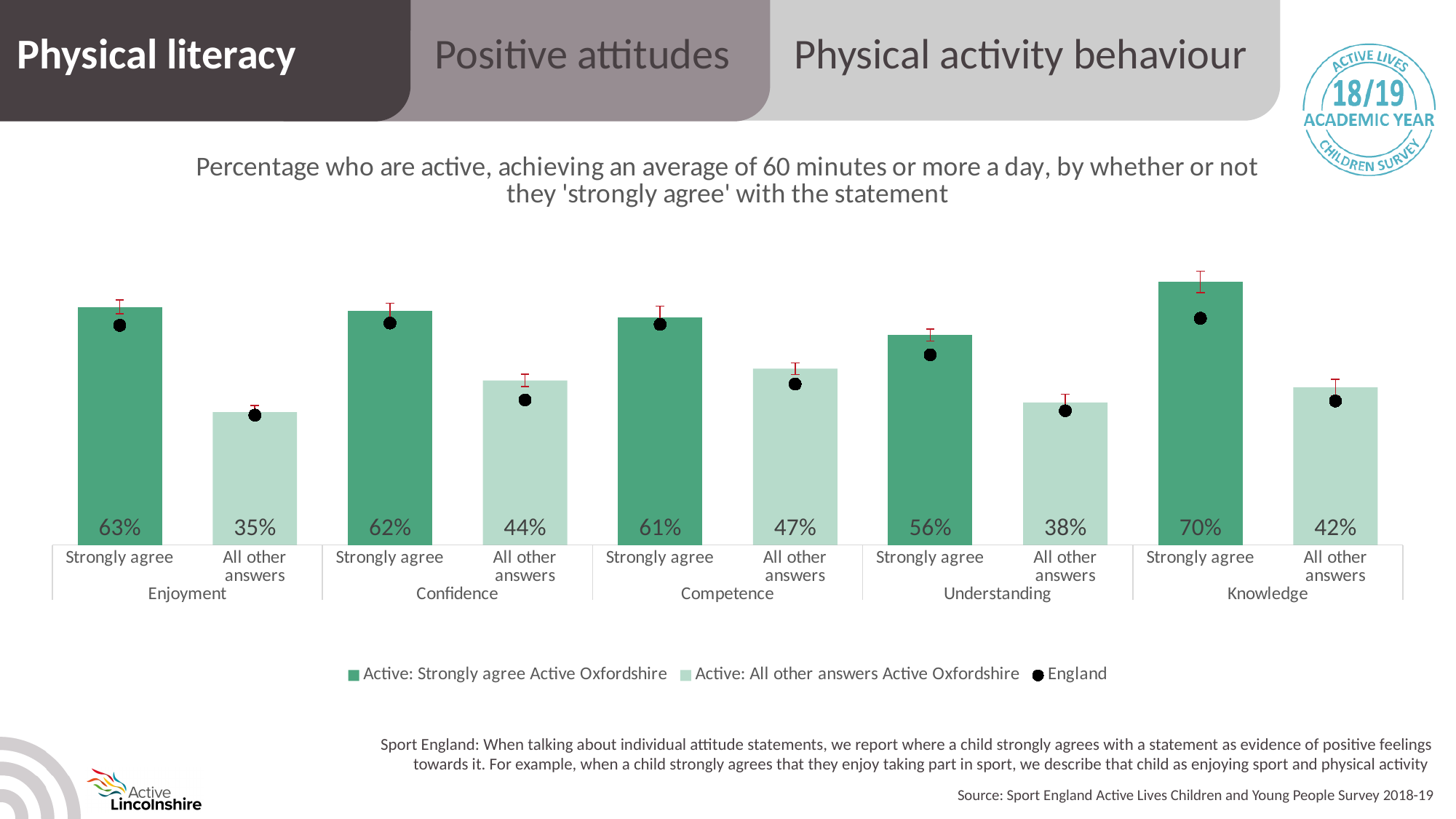
What is the difference between the 'Strongly agree' and 'All other answers' values for Understanding? 18% Which is larger: the 'All other answers' value for Confidence or for Knowledge? Confidence Which statement has the highest 'Strongly agree' value? Knowledge What does the black dot marker in the legend represent? England How many statement categories are shown on the x axis? 5 How many series does the legend list? 3 What kind of chart is shown on the slide? Bar chart What percentage of children who strongly agree with the Enjoyment statement are active? 63% What is the value for 'Strongly agree' under Knowledge? 70% Which statement has the lowest 'All other answers' value? Enjoyment What is the difference between the 'Strongly agree' values for Knowledge and Enjoyment? 7% What is the value for 'All other answers' under Competence? 47%